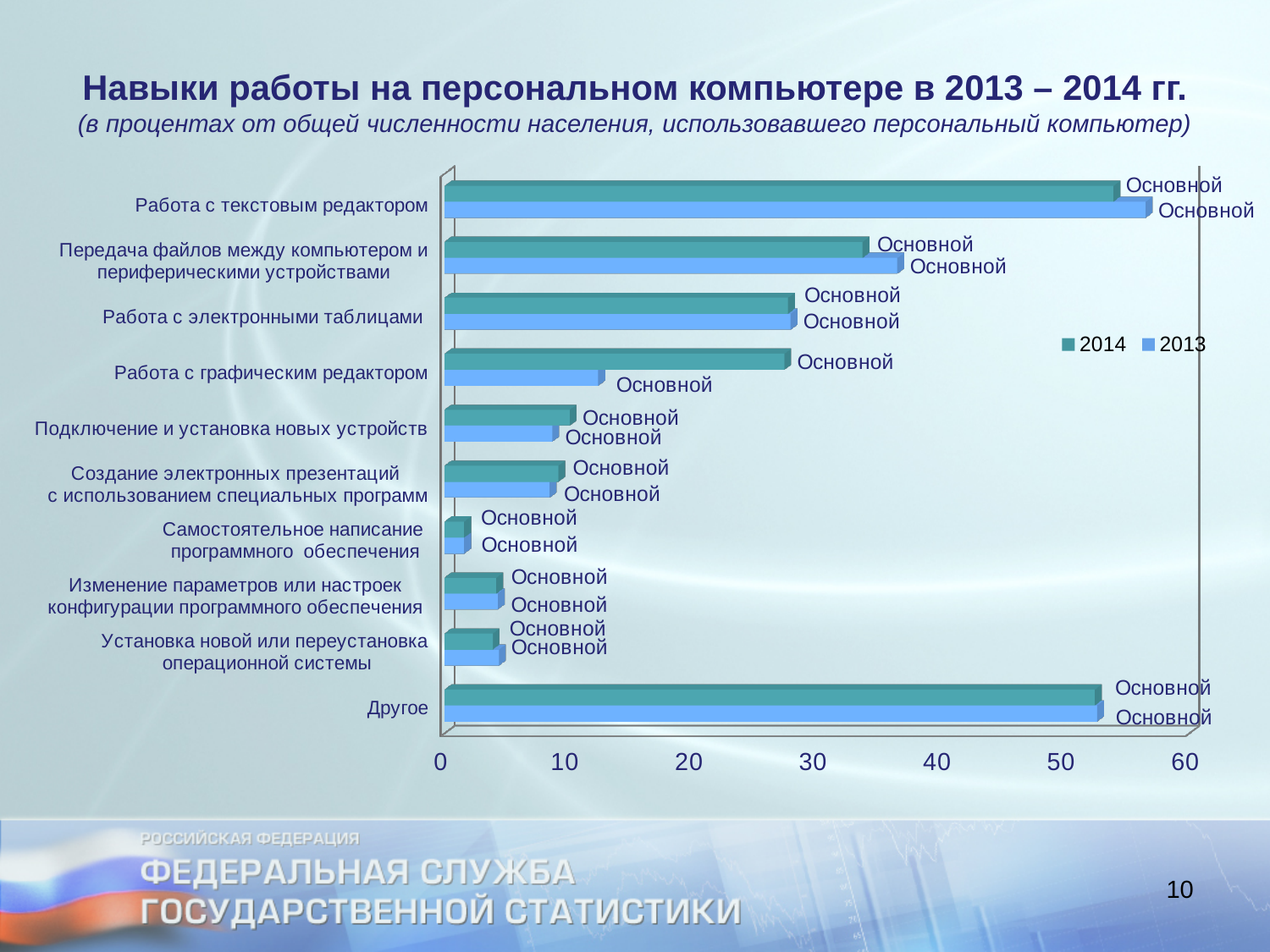
For 'Работа с графическим редактором', which year has the larger value, 2014 or 2013? 2014 Which series are listed in the legend? 2014 and 2013 What kind of chart is shown on the slide? Bar chart How many categories (skills) are plotted on the chart? 10 How many series does the legend list? 2 Which category has the highest value for 2013? Работа с текстовым редактором Is the 2014 value for 'Другое' greater or less than 50? greater Is the 2013 value for 'Работа с текстовым редактором' greater or less than 50? greater For 'Работа с текстовым редактором', which year has the larger value, 2014 or 2013? 2013 Which category has the lowest value for 2014? Самостоятельное написание программного обеспечения Is the 2014 value for 'Передача файлов между компьютером и периферическими устройствами' greater or less than 30? greater